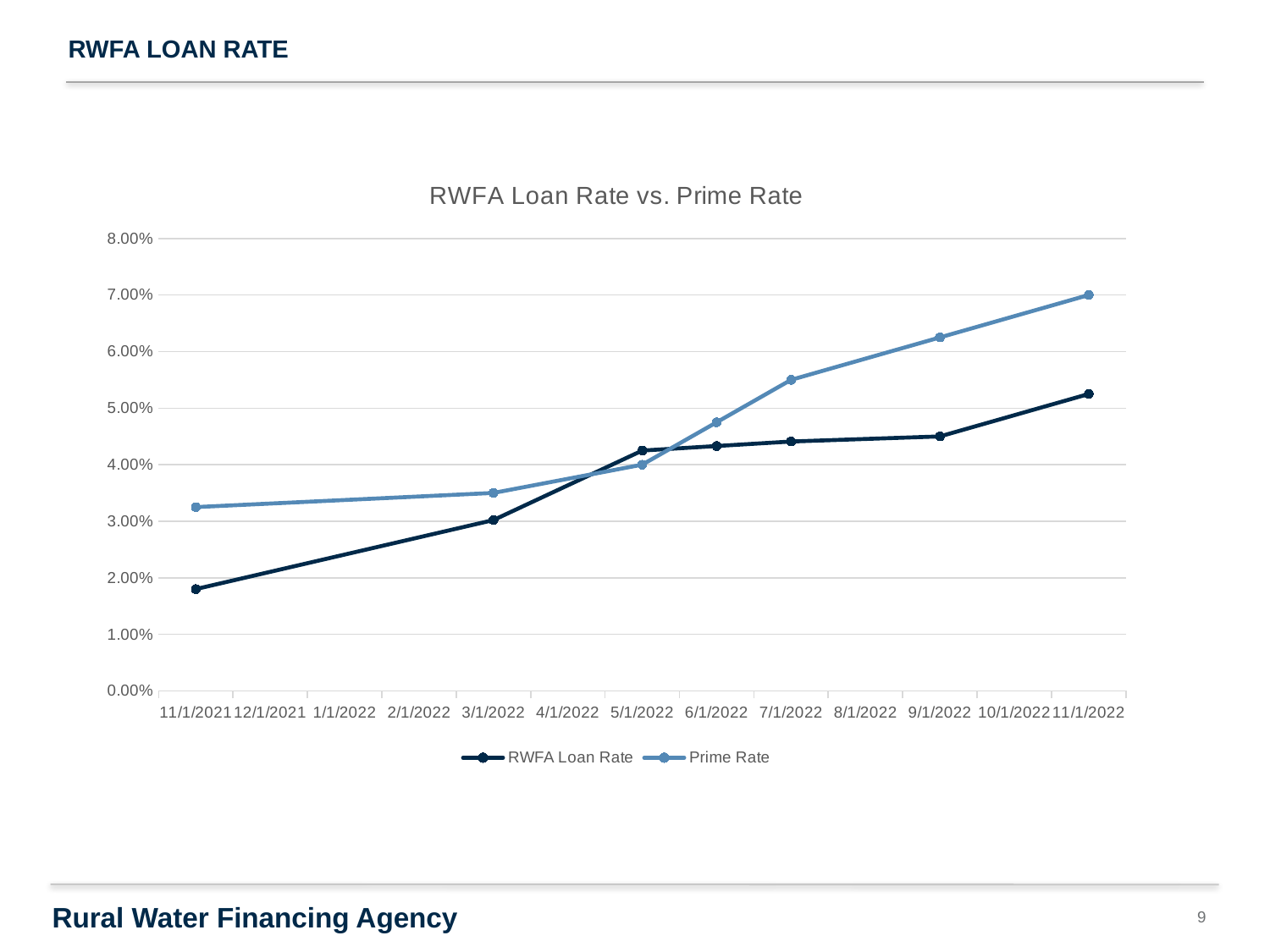
Is the Prime Rate on 7/1/2022 greater or less than 5.00%? greater What is the title of the chart? RWFA Loan Rate vs. Prime Rate Does the RWFA Loan Rate rise or fall from 11/1/2021 to 11/1/2022? rise On which date is the Prime Rate highest? 11/1/2022 What kind of chart is shown on the slide? line chart Is the RWFA Loan Rate on 11/1/2021 greater or less than 2.00%? less Is the Prime Rate on 9/1/2022 greater or less than 6.00%? greater How many series does the legend list? 2 How many dates are labelled along the x axis? 13 What is the Prime Rate on 11/1/2022? 7.00% On 11/1/2022, which is higher, the RWFA Loan Rate or the Prime Rate? Prime Rate